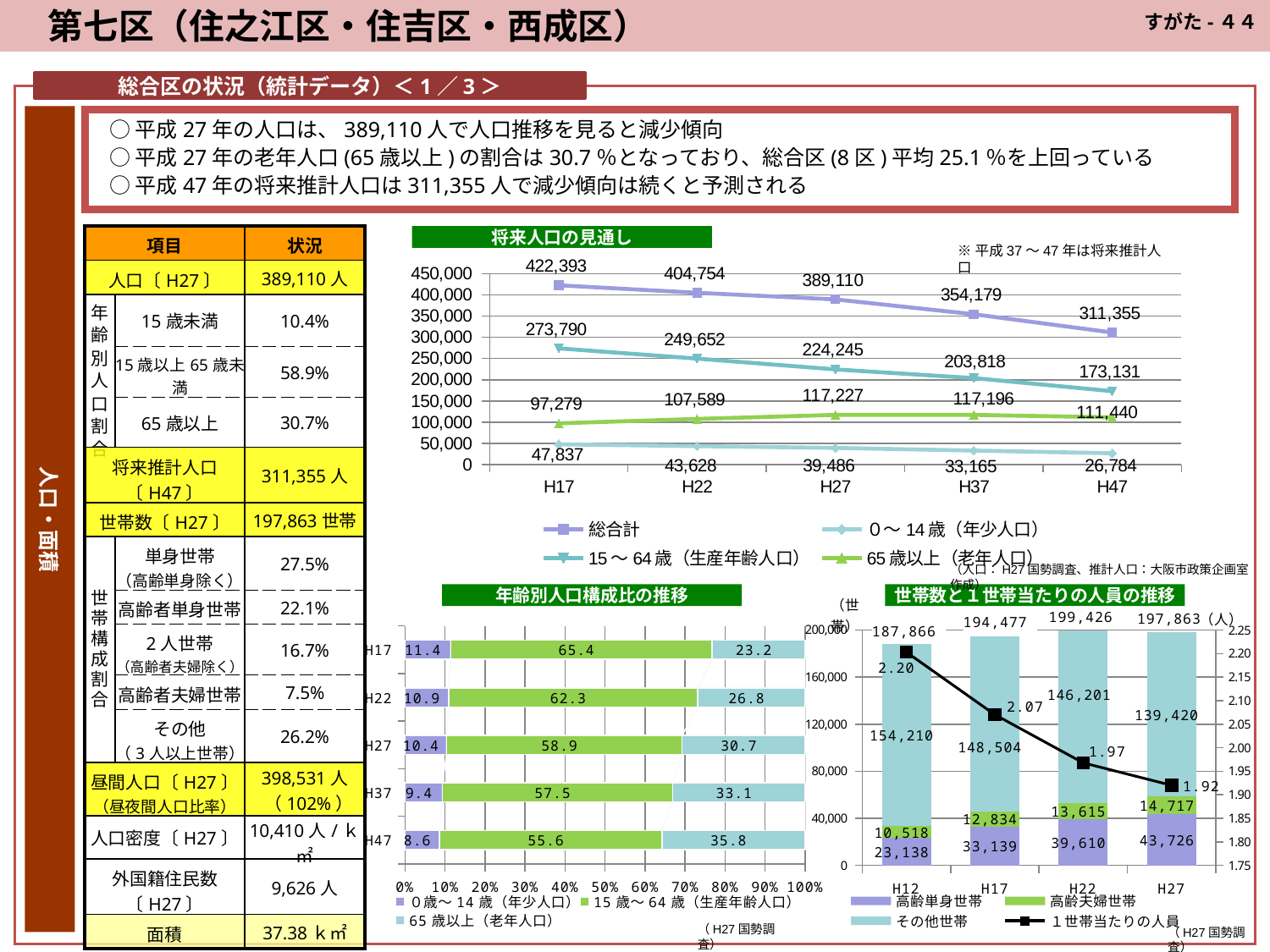
In the 将来人口の見通し chart, what is the difference between the 総合計 values for H17 and H47? 111,038 In the 将来人口の見通し chart, does the 15～64歳（生産年齢人口） series rise or fall from H17 to H47? fall In the 年齢別人口構成比の推移 chart, what is the 65歳以上（老年人口） share for H47? 35.8 In the 世帯数と1世帯当たりの人員の推移 chart, what is the 1世帯当たりの人員 value for H27? 1.92 In the 世帯数と1世帯当たりの人員の推移 chart, which is larger: the 高齢単身世帯 value for H12 or for H27? H27 In the 将来人口の見通し chart, what is the 総合計 value for H27? 389,110 In the 将来人口の見通し chart, how many series does the legend list? 4 In the 将来人口の見通し chart, which year has the lowest 0～14歳（年少人口） value? H47 In the 年齢別人口構成比の推移 chart, which year has the highest 15歳～64歳（生産年齢人口） share? H17 In the 将来人口の見通し chart, what is the 65歳以上（老年人口） value for H37? 117,196 In the 世帯数と1世帯当たりの人員の推移 chart, what is the その他世帯 value for H22? 146,201 What kind of chart is the 年齢別人口構成比の推移 chart? stacked bar chart